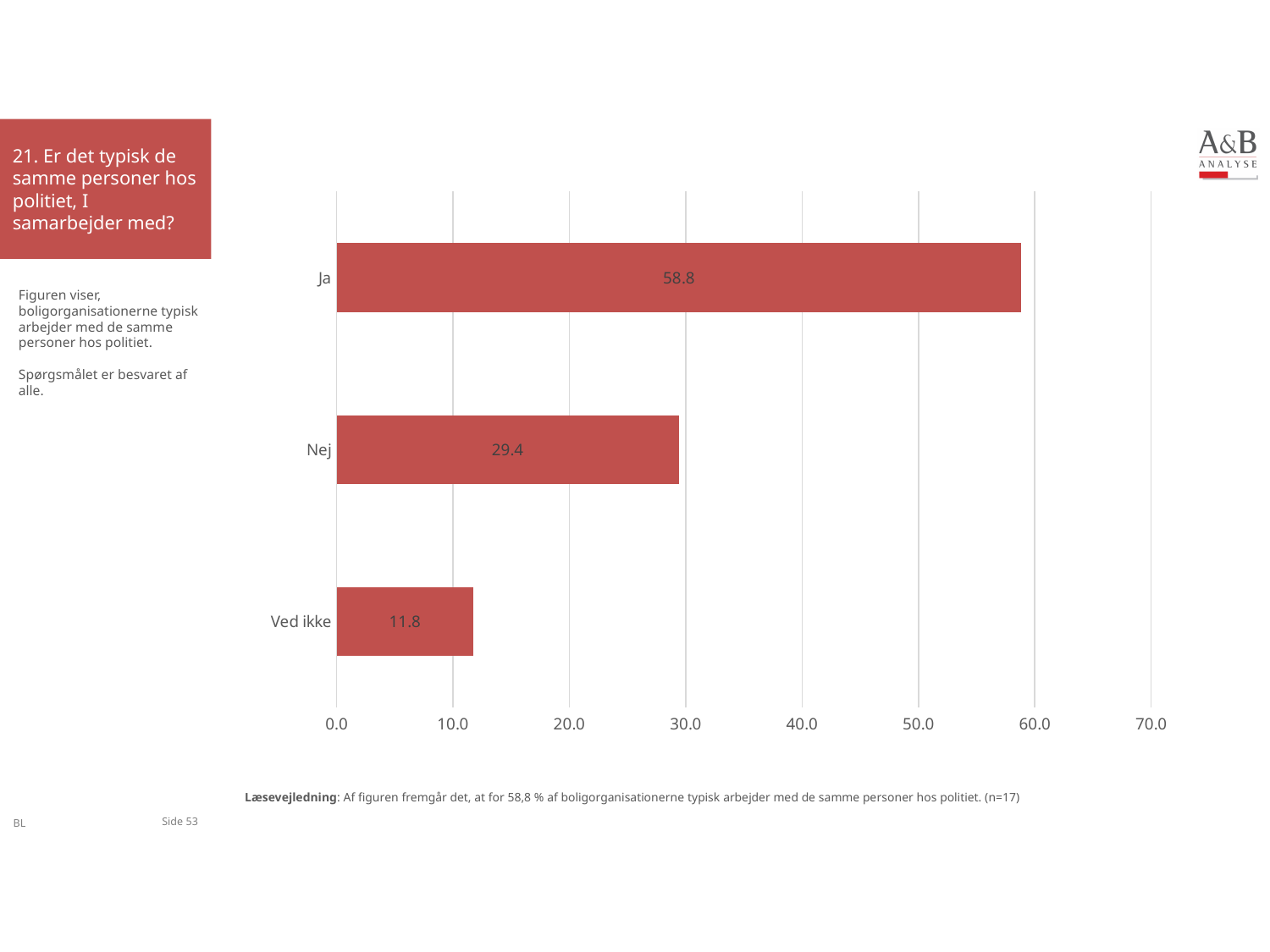
How many categories are shown in the chart? 3 What is the difference between the values for "Nej" and "Ved ikke"? 17.6 What is the highest value shown on the x axis? 70.0 What is the difference between the values for "Ja" and "Nej"? 29.4 Which category has the highest value? Ja What is the value for "Ja"? 58.8 Which category has the lowest value? Ved ikke What is the value for "Ved ikke"? 11.8 Which is larger, the value for "Nej" or the value for "Ved ikke"? Nej What is the value for "Nej"? 29.4 Is the value for "Ja" greater or less than 50.0? greater What kind of chart is shown on the slide? bar chart